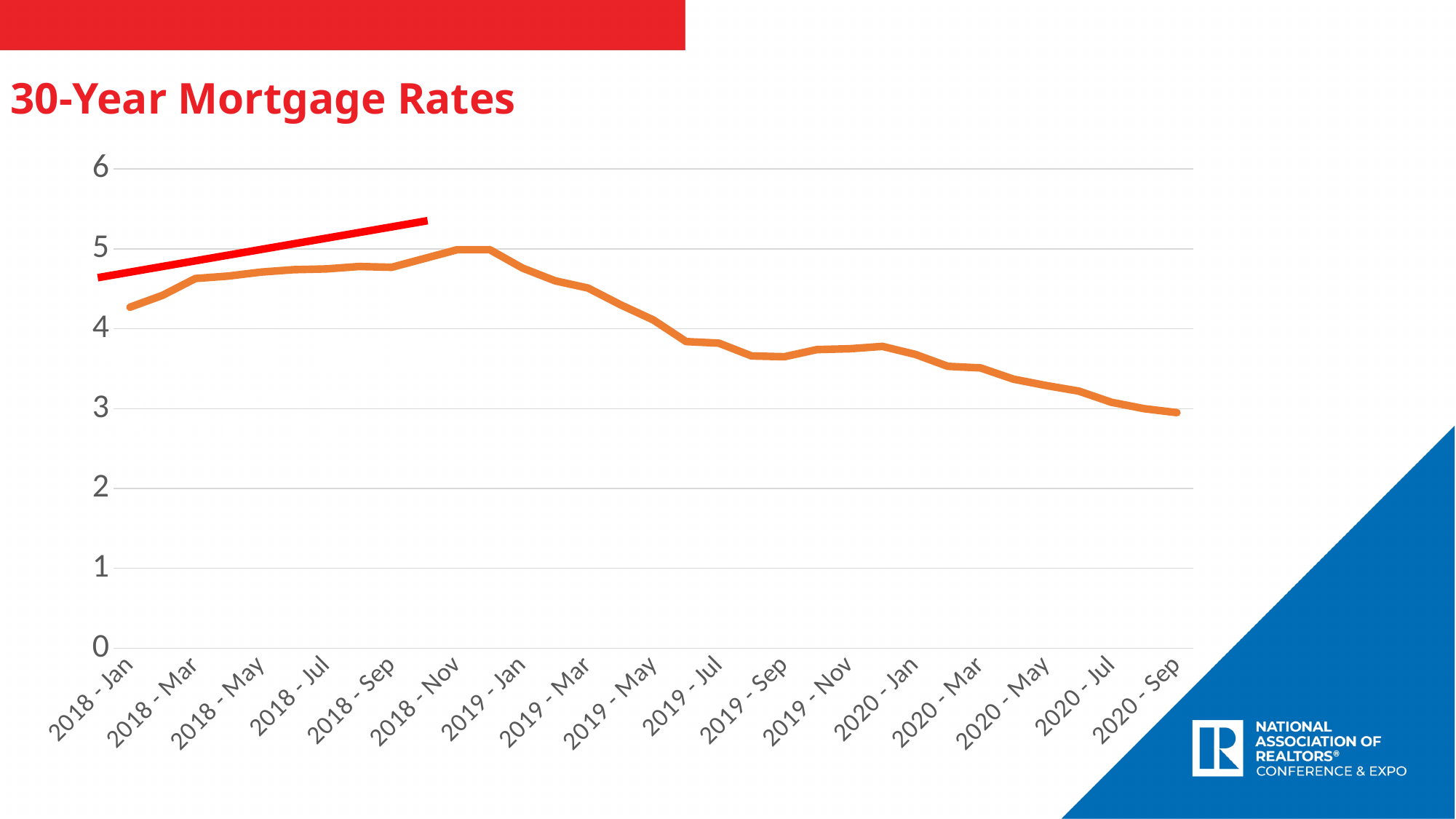
What kind of chart is shown on the slide? line chart Is the value for 2020 - May greater or less than 3? greater Do the values rise or fall from 2019 - Jan to 2020 - Sep? fall Is the value for 2020 - Jan greater or less than 4? less Which is larger, the value for 2019 - Jan or the value for 2020 - Jan? 2019 - Jan How many month labels are shown along the x axis? 17 Is the value for 2019 - Jan greater or less than 4? greater Which month label has the lowest value on the chart? 2020 - Sep Which is larger, the value for 2018 - Jan or the value for 2020 - Sep? 2018 - Jan What is the title of the chart? 30-Year Mortgage Rates